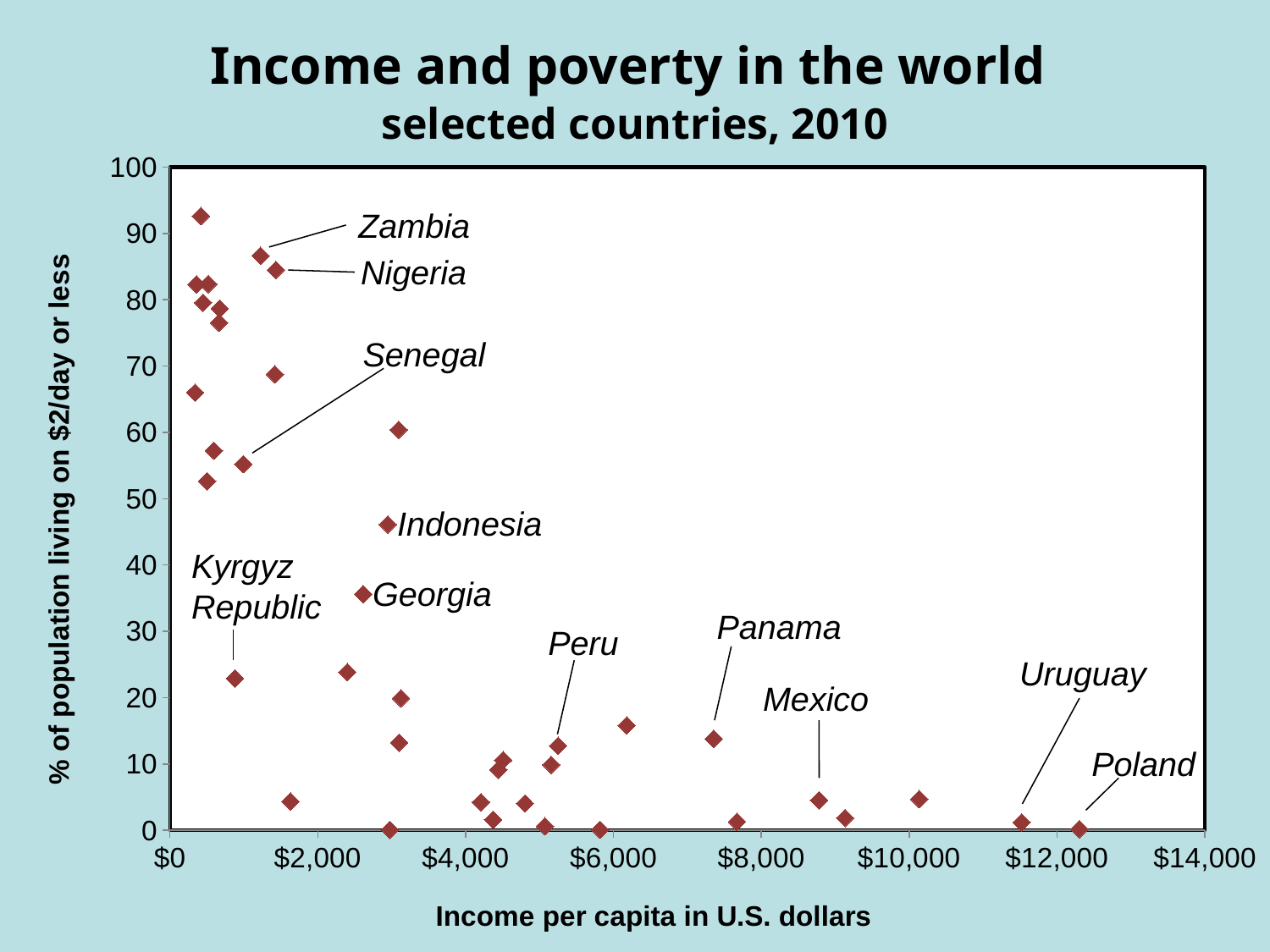
What kind of chart is shown on the slide? scatter chart Which has a higher income per capita, Poland or Kyrgyz Republic? Poland Is the percentage of population living on $2/day or less for Senegal greater or less than 60? less Is the percentage of population living on $2/day or less for Indonesia greater or less than 40? greater Is the income per capita for Poland greater or less than $12,000? greater Which has a higher percentage of population living on $2/day or less, Zambia or Senegal? Zambia What is the label of the x axis? Income per capita in U.S. dollars What is the title of the chart? Income and poverty in the world, selected countries, 2010 As income per capita increases along the x axis, does the percentage of population living on $2/day or less generally rise or fall? fall